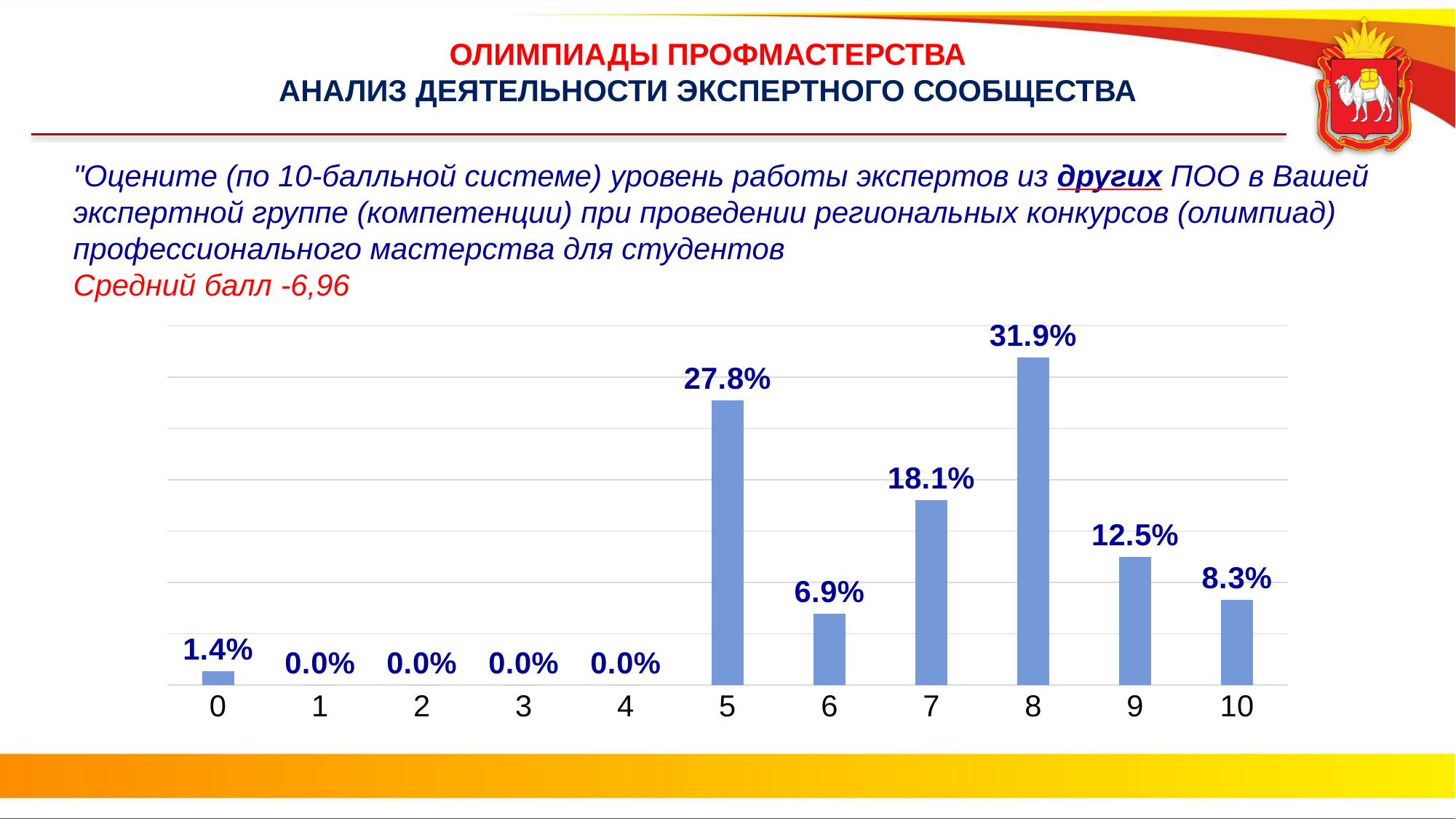
What is the difference between the values for score 7 and score 9? 5.6% Which score has the highest value? 8 How many categories are shown on the x axis? 11 What is the average score (Средний балл) stated on the slide? 6,96 Which is larger, the value for score 9 or the value for score 10? 9 What is the value for score 8? 31.9% How many categories have a value of 0.0%? 4 What is the value for score 6? 6.9% What is the value for score 10? 8.3% What is the difference between the values for score 8 and score 5? 4.1% What is the value for score 5? 27.8% What kind of chart is shown on the slide? bar chart